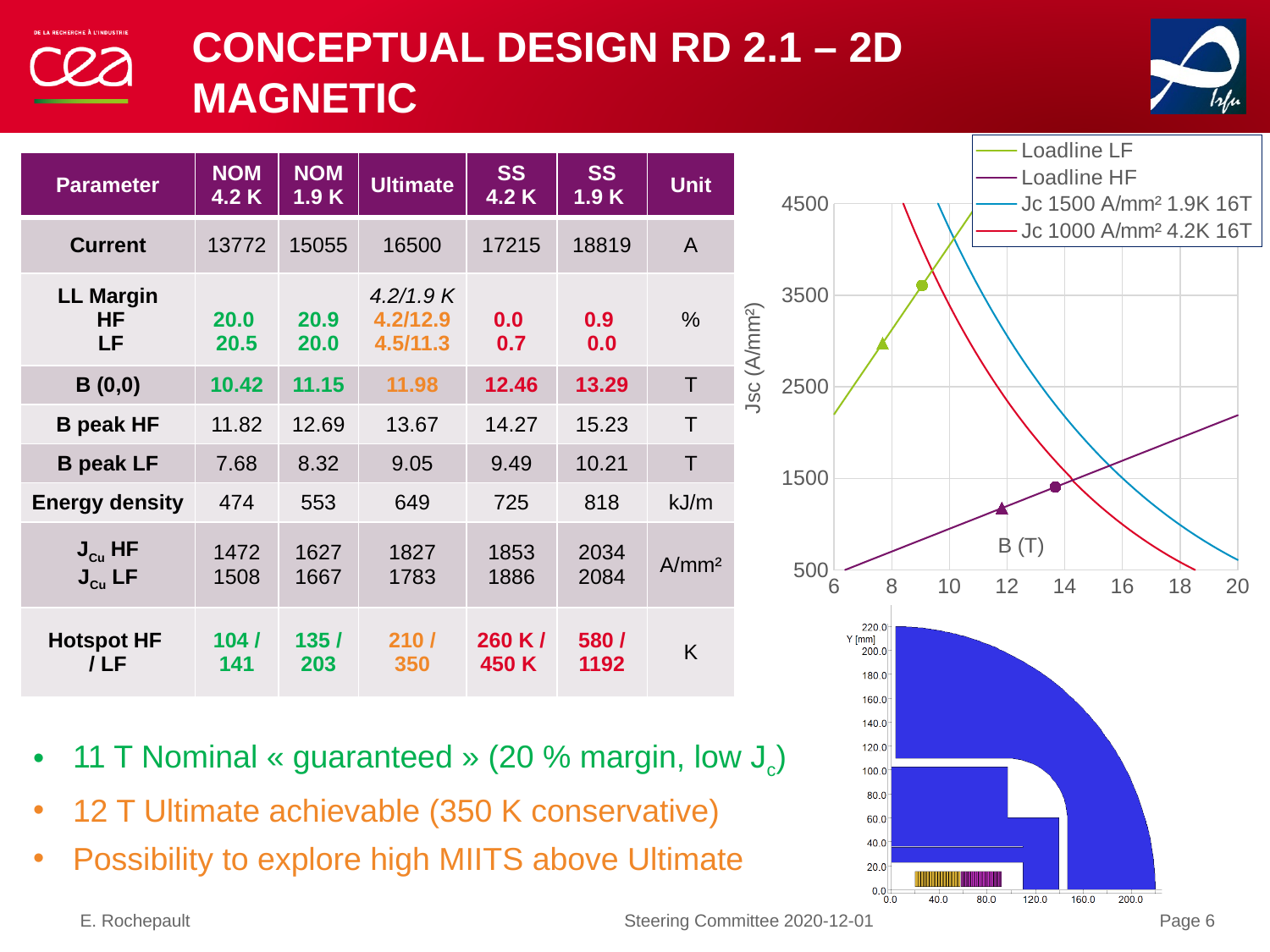
In the line chart, at B = 8 T, which series is higher: Loadline LF or Loadline HF? Loadline LF What kind of chart is shown on the right of the slide? line chart In the line chart, is the Loadline LF value at B = 8 T greater or less than 2500? greater What is the highest value shown on the y axis of the line chart? 4500 What is the label of the x axis of the line chart? B (T) In the line chart, does the Loadline LF series rise or fall as B increases? rise In the line chart, is the Jc 1500 A/mm² 1.9K 16T value at B = 18 T greater or less than 1500? less In the line chart, does the Jc 1500 A/mm² 1.9K 16T series rise or fall as B increases? fall In the line chart, does the Jc 1000 A/mm² 4.2K 16T series rise or fall as B increases? fall How many series does the legend of the line chart list? 4 What is the label of the y axis of the line chart? Jsc (A/mm²) In the line chart, is the Loadline HF value at B = 12 T greater or less than 1500? less